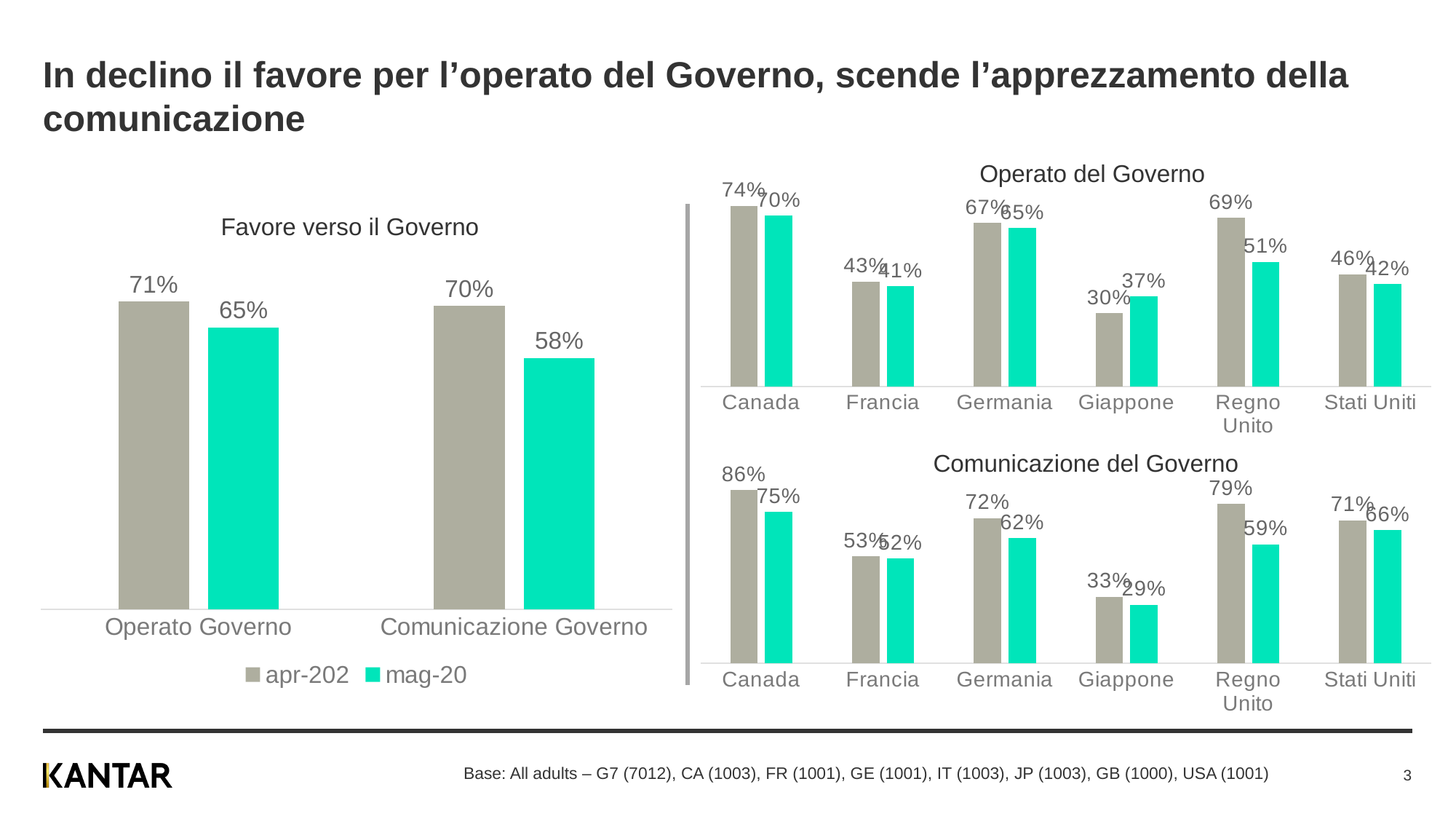
In the 'Comunicazione del Governo' chart, what is the difference between the apr-202 and mag-20 values for Regno Unito? 20 percentage points In the 'Operato del Governo' chart, what is the mag-20 value for Regno Unito? 51% In the 'Favore verso il Governo' chart, what is the mag-20 value for Operato Governo? 65% How many countries are shown in the 'Comunicazione del Governo' chart? 6 In the 'Favore verso il Governo' chart, what is the apr-202 value for Comunicazione Governo? 70% How many series does the legend of the 'Favore verso il Governo' chart list? 2 What kind of chart is 'Operato del Governo'? Bar chart In the 'Comunicazione del Governo' chart, which is larger: the mag-20 value for Germania or the mag-20 value for Regno Unito? Germania In the 'Favore verso il Governo' chart, what is the difference between the apr-202 and mag-20 values for Comunicazione Governo? 12 percentage points In the 'Operato del Governo' chart, which country has the lowest mag-20 value? Giappone In the 'Operato del Governo' chart, which country has the highest apr-202 value? Canada In the 'Comunicazione del Governo' chart, what is the apr-202 value for Canada? 86%